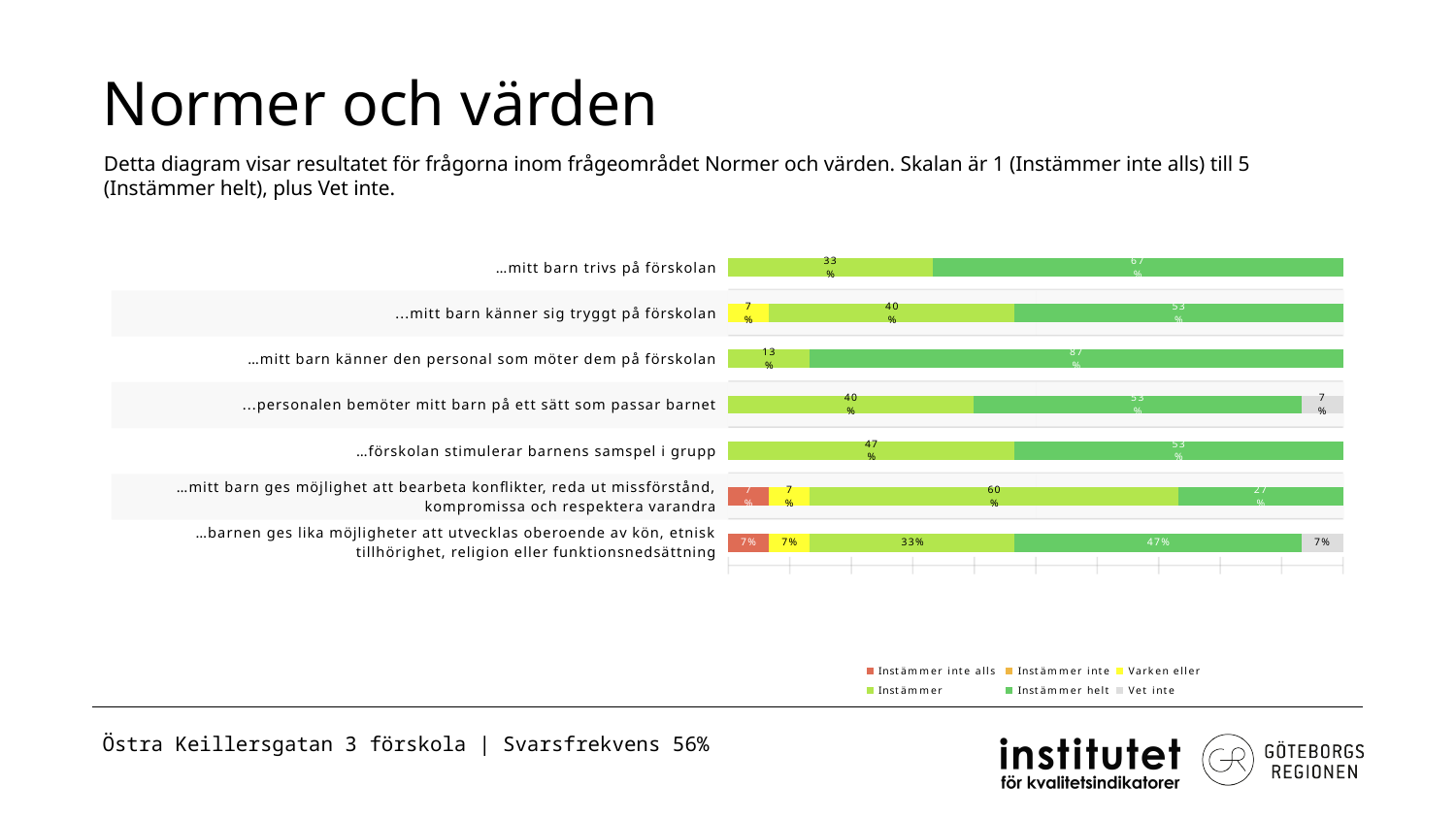
What is the 'Vet inte' value for '…personalen bemöter mitt barn på ett sätt som passar barnet'? 7% What is the 'Instämmer helt' value for '…mitt barn känner den personal som möter dem på förskolan'? 87% What is the 'Instämmer' value for '…mitt barn känner sig tryggt på förskolan'? 40% What kind of chart is shown on the slide? Stacked bar chart How many statements (categories) are plotted in the chart? 7 What is the 'Instämmer helt' value for '…mitt barn trivs på förskolan'? 67% What is the 'Instämmer' value for '…mitt barn ges möjlighet att bearbeta konflikter, reda ut missförstånd, kompromissa och respektera varandra'? 60% How many series does the legend list? 6 Which statement has the highest 'Instämmer helt' value? …mitt barn känner den personal som möter dem på förskolan Which is larger for '…förskolan stimulerar barnens samspel i grupp': the 'Instämmer' value or the 'Instämmer helt' value? Instämmer helt Which statement has the lowest 'Instämmer helt' value? …mitt barn ges möjlighet att bearbeta konflikter, reda ut missförstånd, kompromissa och respektera varandra What is the difference between the 'Instämmer helt' and 'Instämmer' values for '…mitt barn trivs på förskolan'? 34%